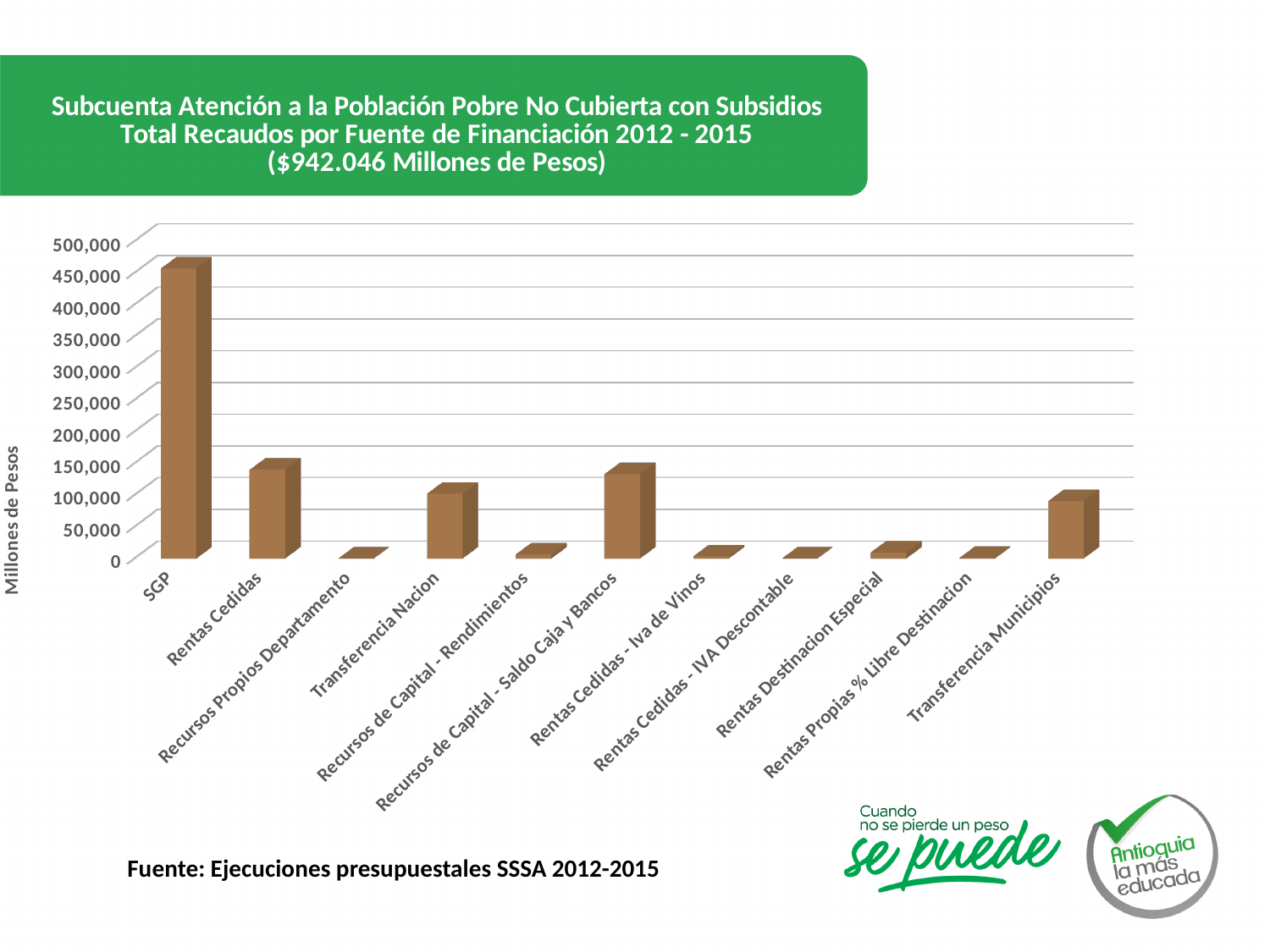
What total amount in millions of pesos is stated in the chart title? $942.046 Millones de Pesos What is the label on the vertical axis of the chart? Millones de Pesos What kind of chart is shown on the slide? Bar chart How many funding source categories are plotted on the x axis? 11 Is the value for Transferencia Municipios greater or less than 150,000? less Is the value for Transferencia Nacion greater or less than 150,000? less Which is larger, the value for Rentas Cedidas or the value for Transferencia Nacion? Rentas Cedidas Is the value for Rentas Cedidas greater or less than 100,000? greater Which is larger, the value for SGP or the value for Rentas Cedidas? SGP Which funding source has the highest bar? SGP